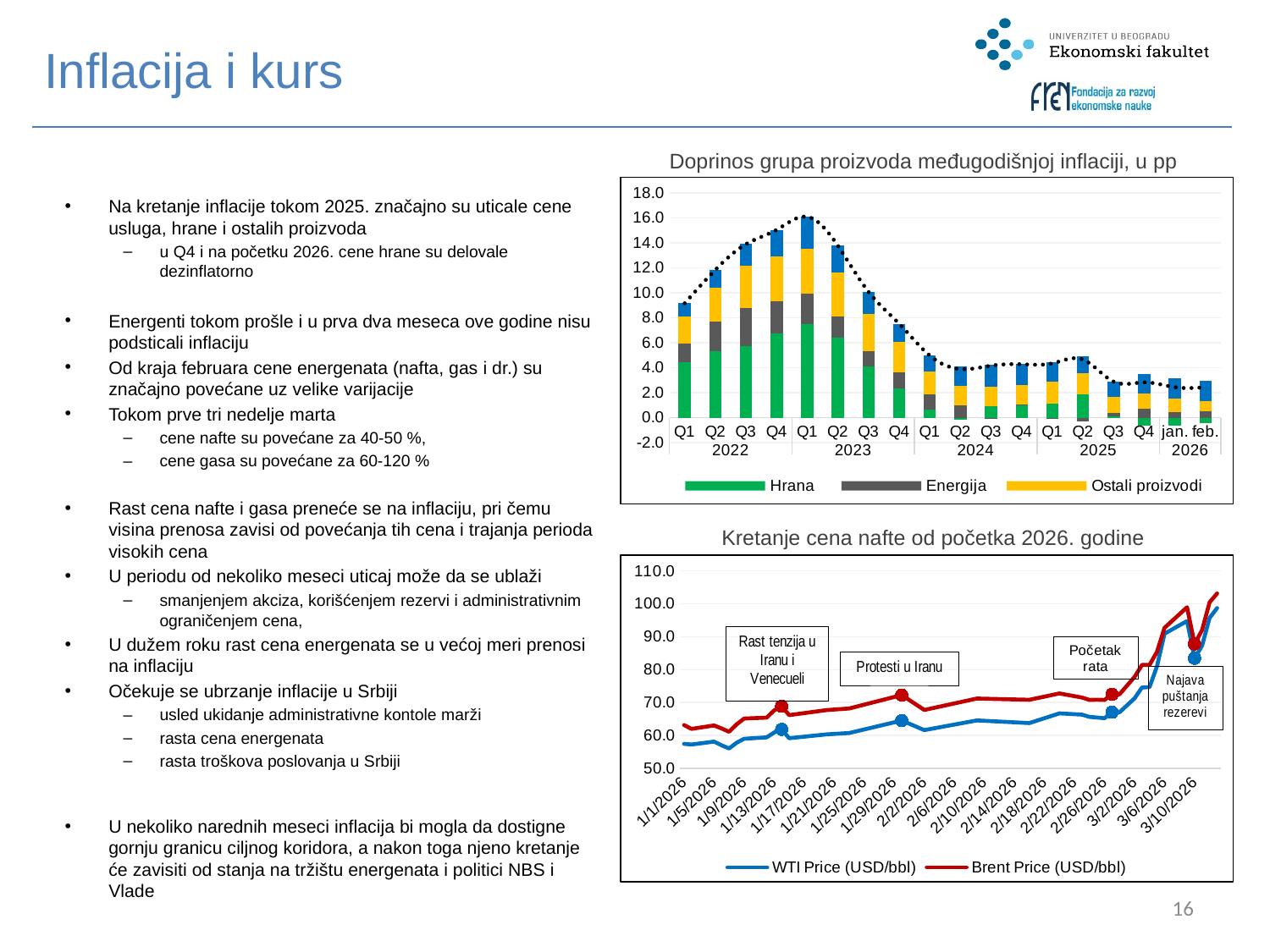
What kind of chart is the chart titled 'Doprinos grupa proizvoda međugodišnjoj inflaciji, u pp'? Stacked bar chart In the chart 'Doprinos grupa proizvoda međugodišnjoj inflaciji, u pp', which colour represents the series 'Hrana'? Green In the chart 'Kretanje cena nafte od početka 2026. godine', which series is higher on 3/10/2026, WTI Price or Brent Price? Brent Price (USD/bbl) How many series does the legend of the chart 'Doprinos grupa proizvoda međugodišnjoj inflaciji, u pp' list? 3 In the chart 'Kretanje cena nafte od početka 2026. godine', do the prices rise or fall from 2/26/2026 to 3/10/2026? rise In the chart 'Doprinos grupa proizvoda međugodišnjoj inflaciji, u pp', is the total for Q1 2024 greater or less than 6.0? less In the chart 'Doprinos grupa proizvoda međugodišnjoj inflaciji, u pp', is the total for Q1 2023 greater or less than 14.0? greater In the chart 'Doprinos grupa proizvoda međugodišnjoj inflaciji, u pp', which quarter has the highest total bar? Q1 2023 How many series does the legend of the chart 'Kretanje cena nafte od početka 2026. godine' list? 2 In the chart 'Kretanje cena nafte od početka 2026. godine', is the Brent Price on 3/10/2026 greater or less than 100.0? less In the chart 'Doprinos grupa proizvoda međugodišnjoj inflaciji, u pp', do the total bars rise or fall from Q1 2023 to Q1 2024? fall What kind of chart is the chart titled 'Kretanje cena nafte od početka 2026. godine'? Line chart